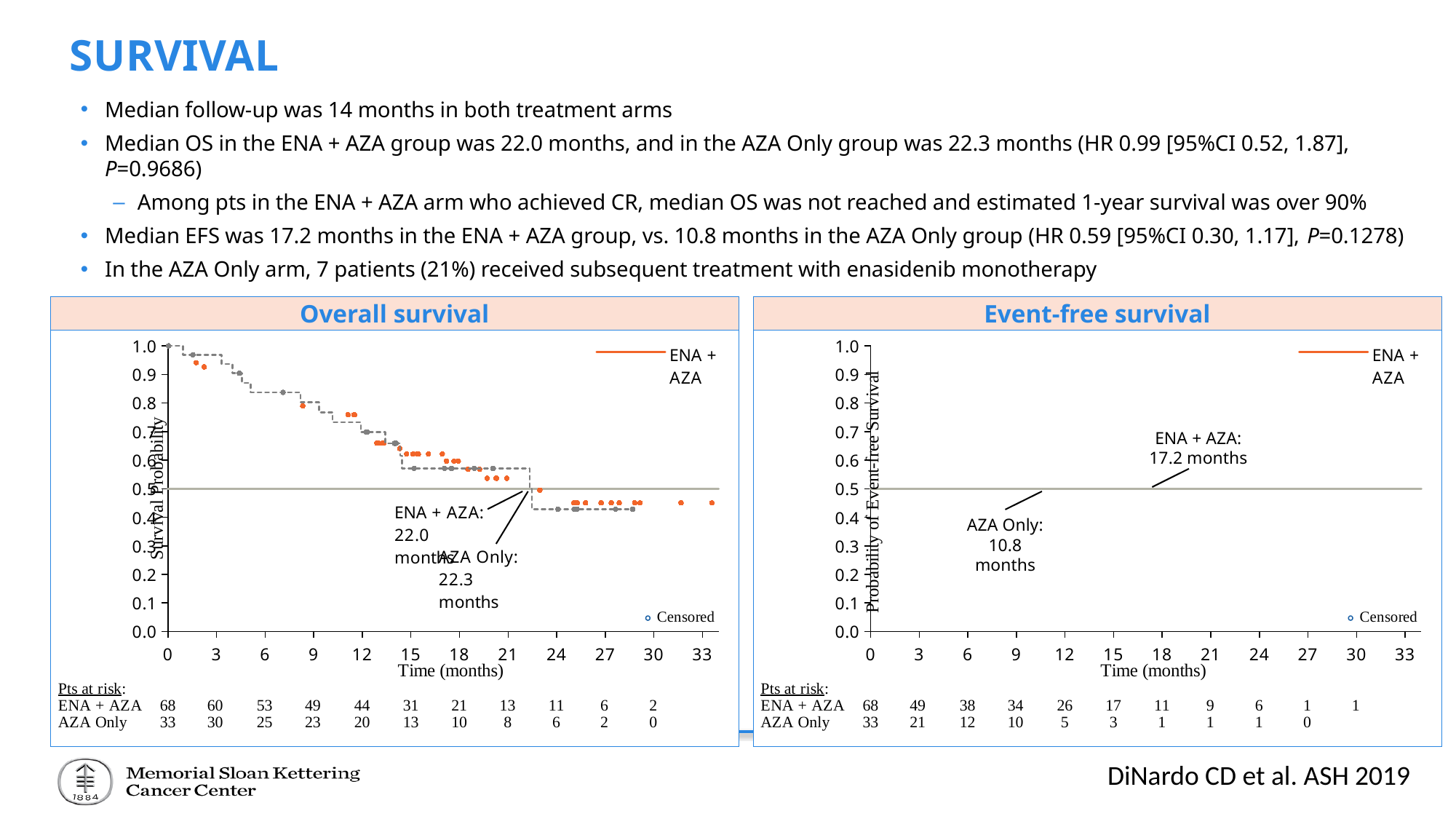
On the Event-free survival chart, what median EFS is annotated for the ENA + AZA group? 17.2 months On the Overall survival chart, is the ENA + AZA survival probability at 33 months greater or less than 0.5? less On the Overall survival chart, how many AZA Only patients are at risk at 15 months? 13 On the Event-free survival chart, what median EFS is annotated for the AZA Only group? 10.8 months On the Overall survival chart, what median OS is annotated for the AZA Only group? 22.3 months On the Overall survival chart, do the survival curves rise or fall as time increases? fall On the Event-free survival chart, what is the difference between the annotated median EFS values for ENA + AZA and AZA Only? 6.4 months On the Overall survival chart, how many ENA + AZA patients are at risk at 0 months? 68 On the Overall survival chart, which group has the larger annotated median OS, ENA + AZA or AZA Only? AZA Only On the Overall survival chart, what median OS is annotated for the ENA + AZA group? 22.0 months What kind of chart is the Overall survival chart? line chart On the Event-free survival chart, how many ENA + AZA patients are at risk at 12 months? 26